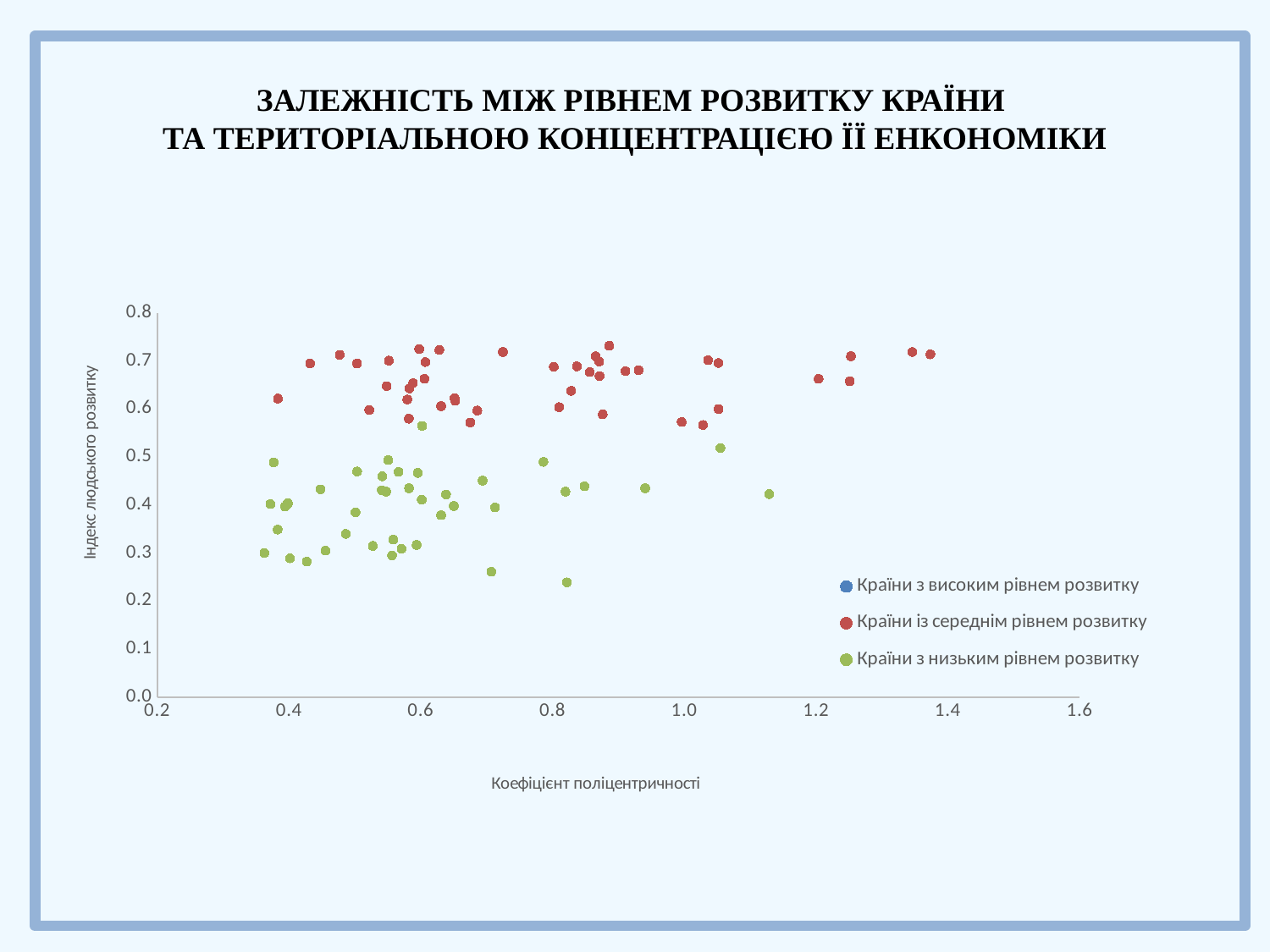
What is the label of the horizontal axis? Коефіцієнт поліцентричності What kind of chart is shown on the slide? Scatter chart How many series does the legend list? 3 Are the points for 'Країни із середнім рівнем розвитку' generally greater or less than 0.5 on the vertical axis? greater What is the title of the chart? ЗАЛЕЖНІСТЬ МІЖ РІВНЕМ РОЗВИТКУ КРАЇНИ ТА ТЕРИТОРІАЛЬНОЮ КОНЦЕНТРАЦІЄЮ ЇЇ ЕНКОНОМІКИ Which series is plotted with red markers? Країни із середнім рівнем розвитку Which series has the higher values on the vertical axis, 'Країни із середнім рівнем розвитку' or 'Країни з низьким рівнем розвитку'? Країни із середнім рівнем розвитку Are the points for 'Країни з низьким рівнем розвитку' generally greater or less than 0.6 on the vertical axis? less